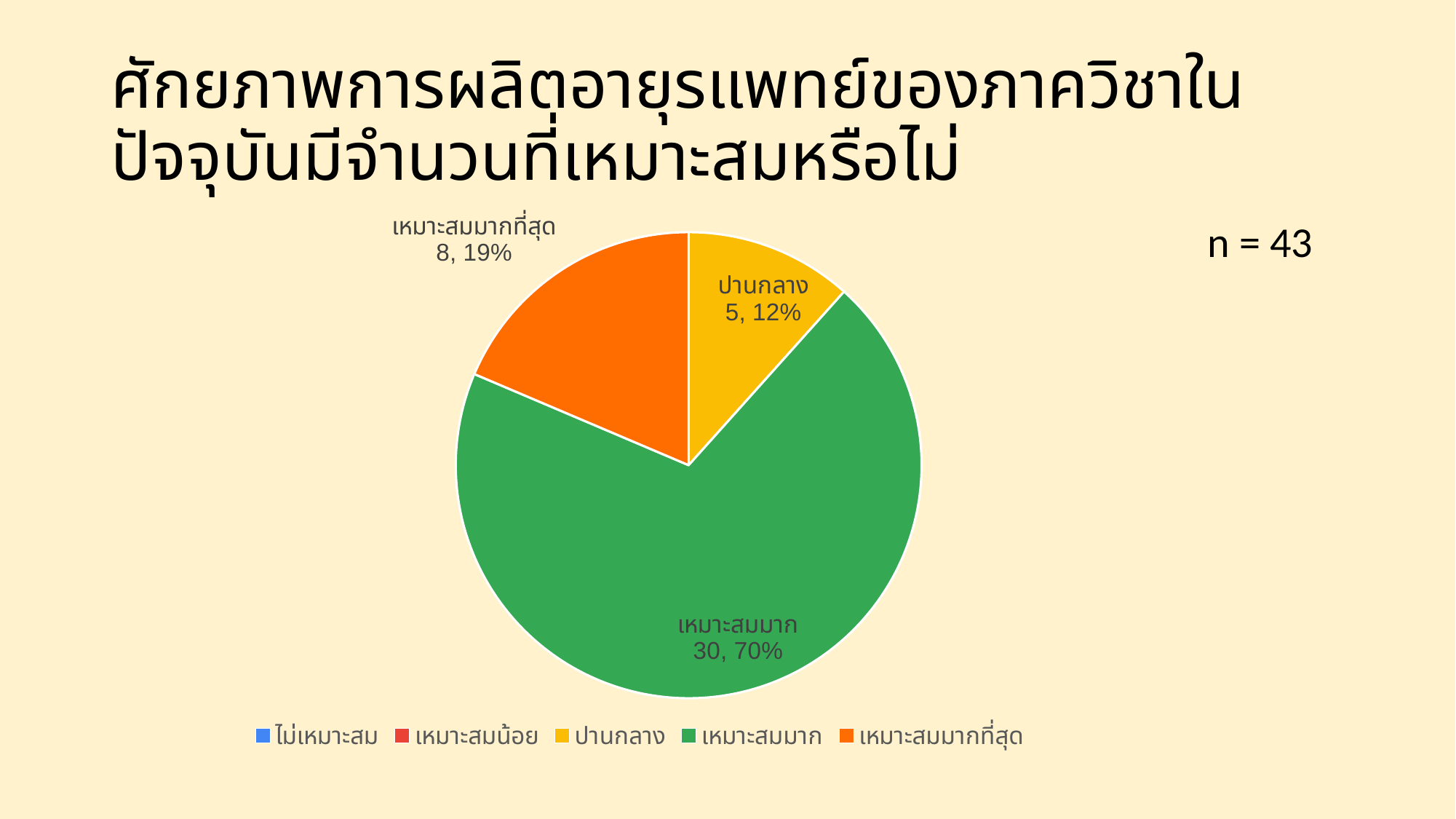
What kind of chart is shown on the slide? pie chart What percentage share does the ปานกลาง slice have? 12% How many slices with data labels are shown in the pie chart? 3 Which of the visible slices is the smallest? ปานกลาง Which category has the largest slice of the pie? เหมาะสมมาก How many respondents does the pie chart represent, according to the slide? n = 43 How many categories does the legend list? 5 What is the difference in count between เหมาะสมมาก and เหมาะสมมากที่สุด? 22 What is the count for the เหมาะสมมากที่สุด slice? 8 What is the count for the เหมาะสมมาก slice? 30 What percentage share does the เหมาะสมมาก slice have? 70% Which is larger, the count for เหมาะสมมากที่สุด or the count for ปานกลาง? เหมาะสมมากที่สุด